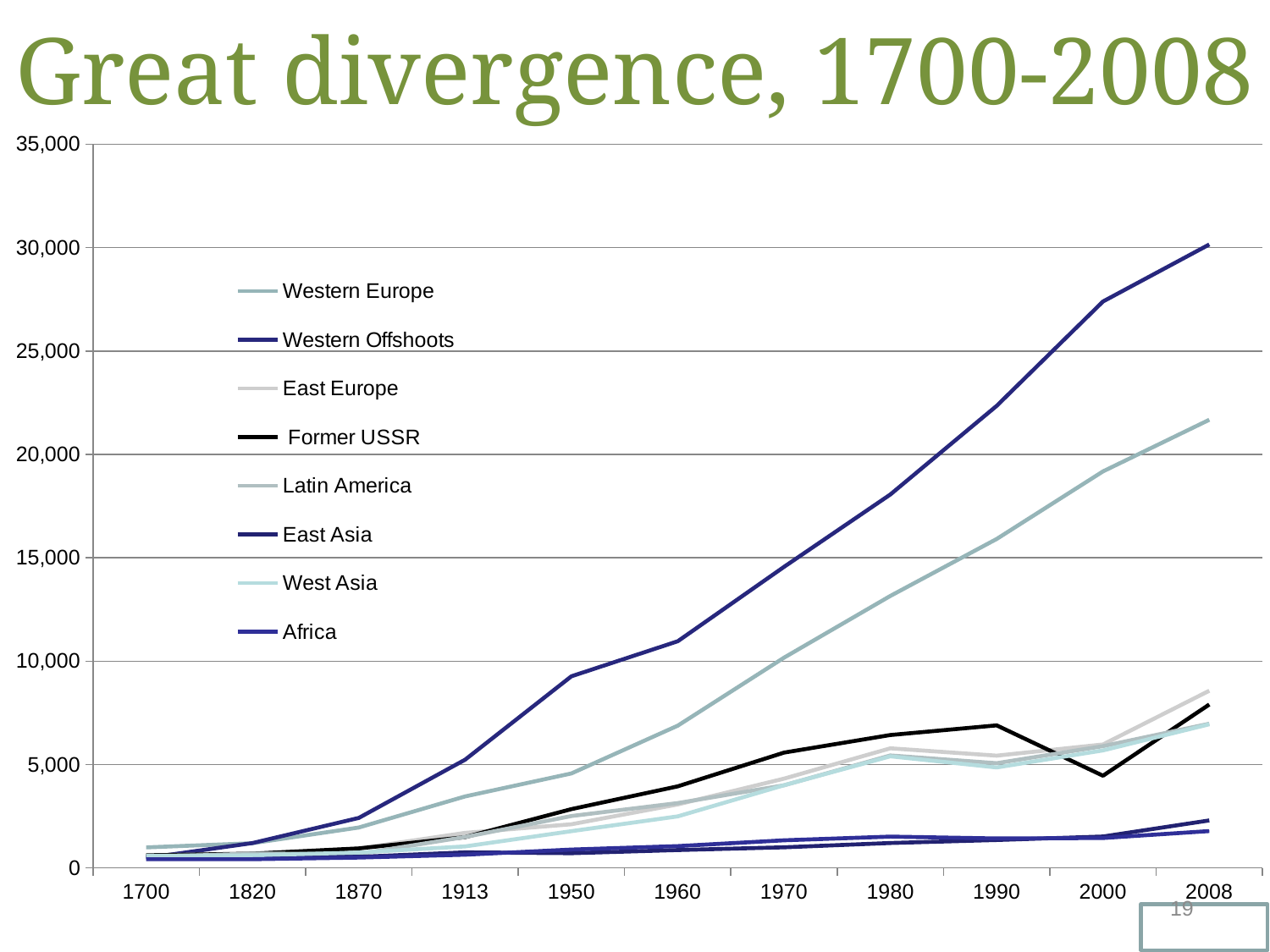
How many years are labelled along the x axis? 11 Which is larger in 1990, Former USSR or East Europe? Former USSR Is the value for Western Europe in 2008 greater or less than 20,000? greater What is the title of the chart? Great divergence, 1700-2008 Which series has the highest value in 2008? Western Offshoots What kind of chart is shown on the slide? line chart Is the value for Western Offshoots in 2008 greater or less than 25,000? greater Which is larger in 2008, Western Offshoots or Western Europe? Western Offshoots Is the value for Western Offshoots in 2000 greater or less than 25,000? greater Does the Former USSR line rise or fall between 1990 and 2000? fall How many series does the legend list? 8